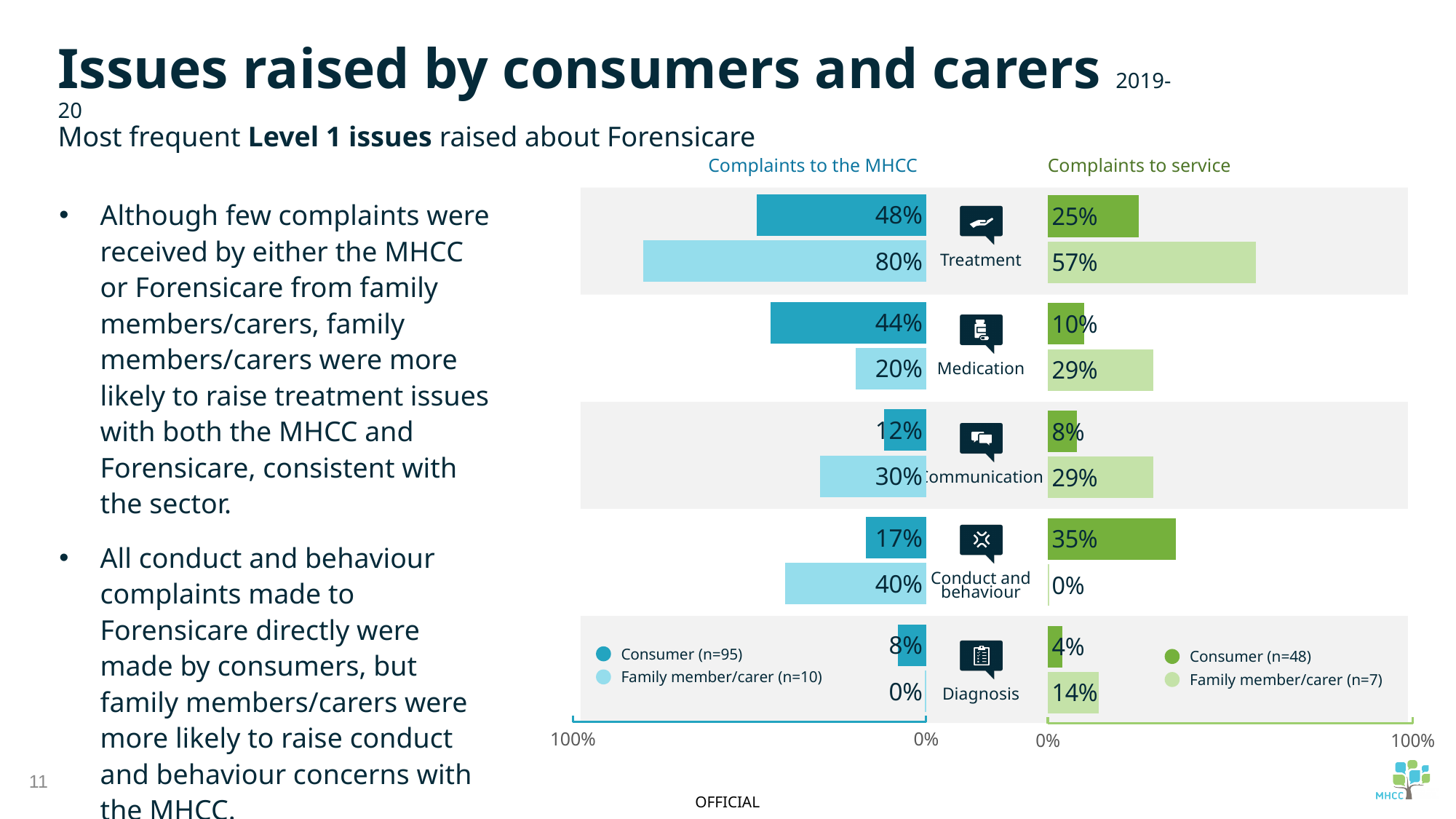
In the 'Complaints to service' chart, what percentage of Consumer complaints were about Conduct and behaviour? 35% In the 'Complaints to the MHCC' chart, what percentage of Family member/carer complaints were about Conduct and behaviour? 40% In the 'Complaints to service' chart, which is larger for Medication: the Consumer percentage or the Family member/carer percentage? Family member/carer According to the legend of the 'Complaints to the MHCC' chart, how many consumers are in the Consumer sample? n=95 In the 'Complaints to the MHCC' chart, which issue has the highest Family member/carer percentage? Treatment What type of chart is the 'Complaints to the MHCC' chart? Bar chart In the 'Complaints to the MHCC' chart, what percentage of Consumer complaints were about Treatment? 48% In the 'Complaints to service' chart, which issue has the lowest Consumer percentage? Diagnosis How many issue categories are shown in the 'Complaints to the MHCC' chart? 5 In the 'Complaints to the MHCC' chart, what is the difference between the Family member/carer and Consumer percentages for Treatment? 32% In the 'Complaints to service' chart, what percentage of Family member/carer complaints were about Treatment? 57% How many series does the legend of the 'Complaints to service' chart list? 2